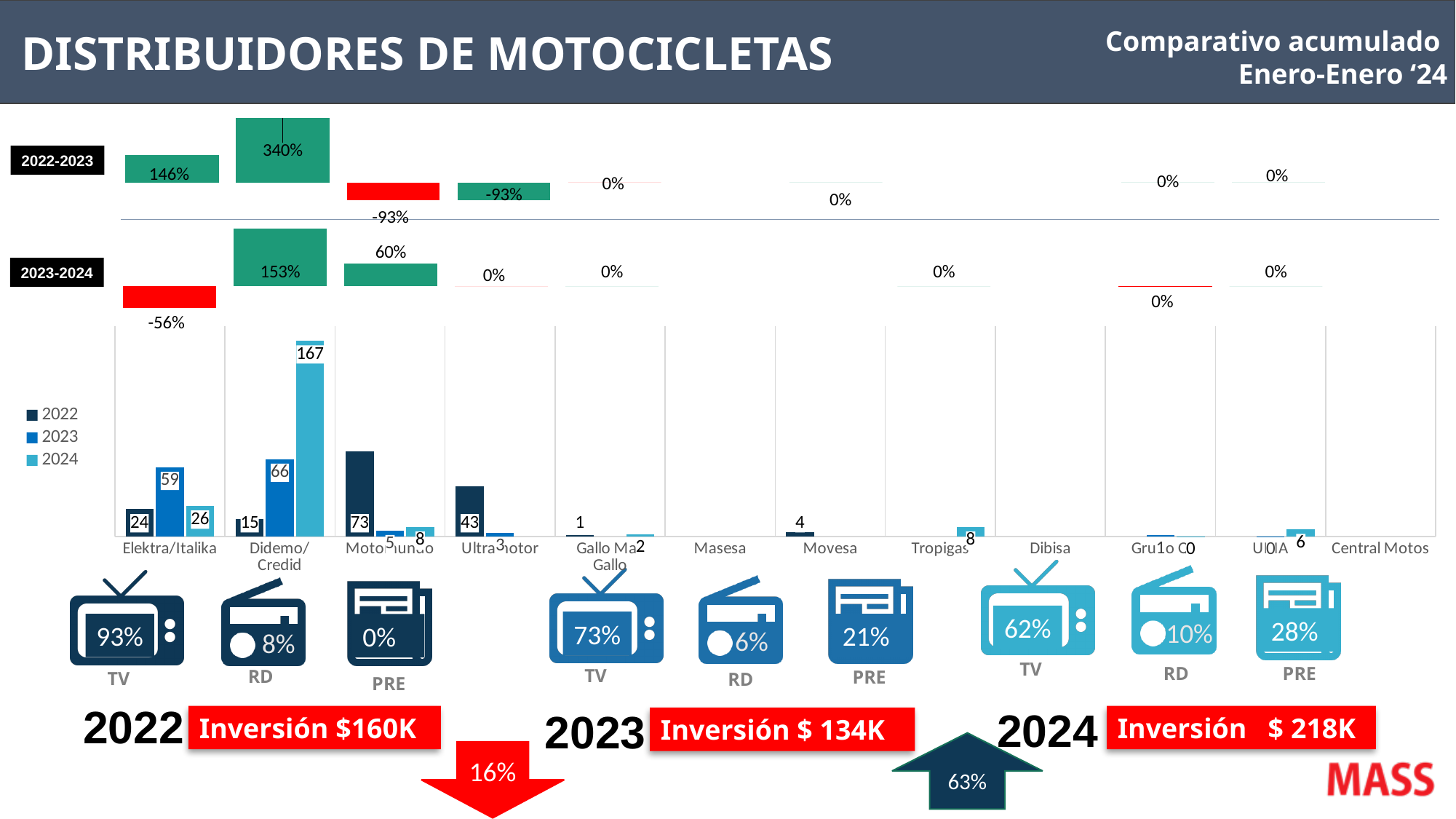
What kind of chart is the bottom chart with the 2022/2023/2024 legend? Bar chart In the bottom bar chart with the 2022/2023/2024 legend, which distributor has the highest 2024 value? Didemo/Credid In the bottom bar chart with the 2022/2023/2024 legend, which is larger: the 2023 value for Elektra/Italika or the 2023 value for Didemo/Credid? Didemo/Credid In the bottom bar chart with the 2022/2023/2024 legend, what is the 2024 value for Didemo/Credid? 167 In the 2023-2024 chart, what is the value shown for Elektra/Italika? -56% In the bottom bar chart with the 2022/2023/2024 legend, which distributor has the highest 2022 value? Motomundo In the bottom bar chart with the 2022/2023/2024 legend, what is the 2023 value for Motomundo? 5 In the bottom bar chart with the 2022/2023/2024 legend, what is the difference between the 2023 and 2022 values for Elektra/Italika? 35 In the 2022-2023 chart at the top, what is the value shown for Didemo/Credid? 340% In the bottom bar chart with the 2022/2023/2024 legend, what is the 2022 value for Motomundo? 73 How many series does the legend of the bottom bar chart list? 3 How many distributor categories are shown on the x axis of the bottom bar chart? 12